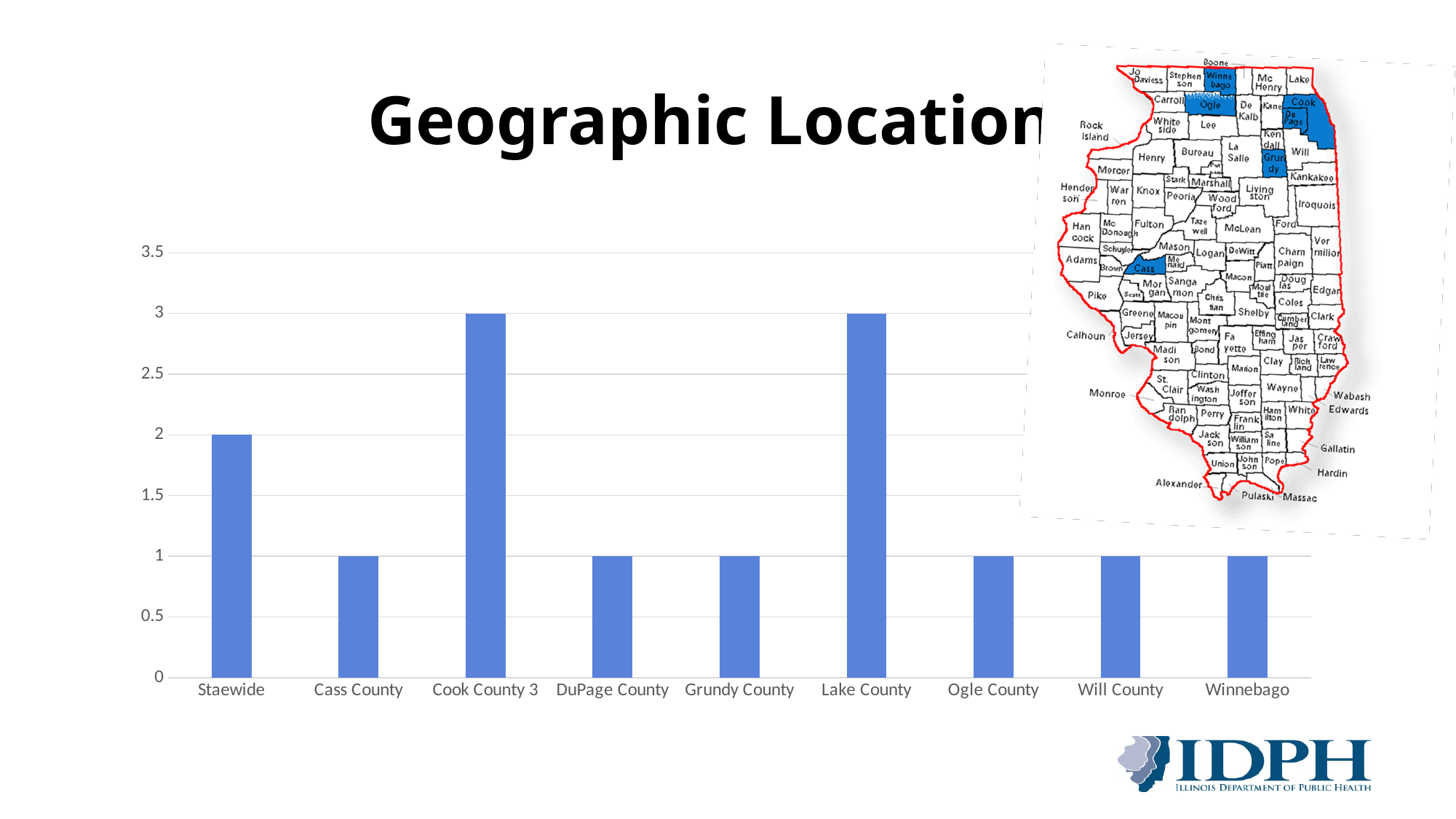
What type of chart is shown on the slide? Bar chart Is the value for Staewide greater or less than 1.5? greater Which is larger, the value for Staewide or the value for Ogle County? Staewide What is the difference between the value for Lake County and the value for Staewide? 1 What is the value for Staewide? 2 What is the value for Lake County? 3 What is the title of the chart? Geographic Location What is the value for Winnebago? 1 What is the value for Cass County? 1 Which is larger, the value for Cook County 3 or the value for DuPage County? Cook County 3 How many categories are shown on the x axis? 9 What is the value for Cook County 3? 3